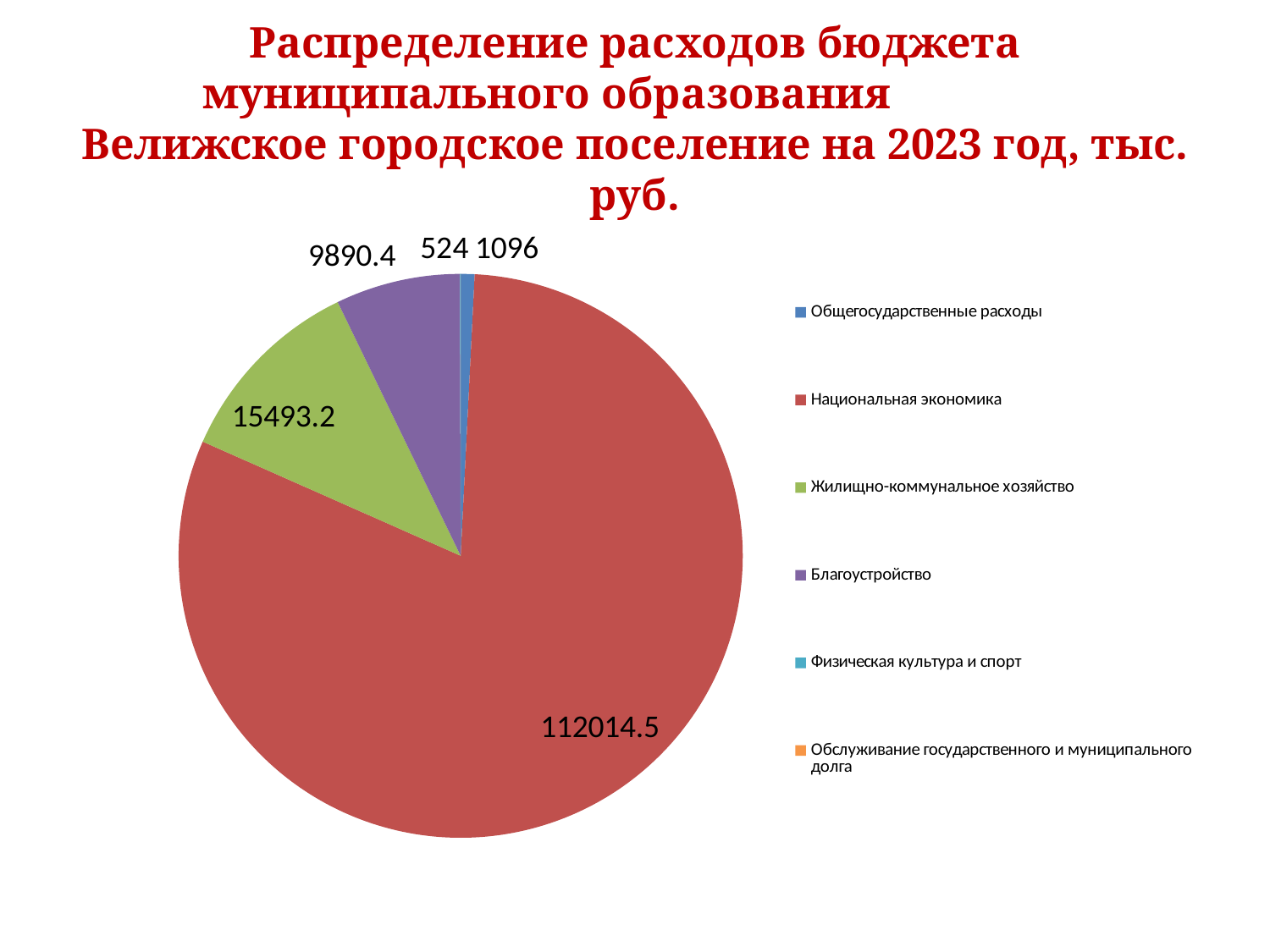
What is the value for Жилищно-коммунальное хозяйство in the pie chart? 15493.2 How many categories does the legend of the pie chart list? 6 What is the difference between the values for Национальная экономика and Жилищно-коммунальное хозяйство? 96521.3 What is the value for Благоустройство in the pie chart? 9890.4 Which category has the largest slice in the pie chart? Национальная экономика For which year does the chart title say the budget expenditures are distributed? 2023 What kind of chart is shown on the slide? pie chart What colour is the slice for Национальная экономика? red Which is larger, Жилищно-коммунальное хозяйство or Благоустройство? Жилищно-коммунальное хозяйство Which is larger, Национальная экономика or Благоустройство? Национальная экономика What is the value for Национальная экономика in the pie chart? 112014.5 What is the difference between the values for Жилищно-коммунальное хозяйство and Благоустройство? 5602.8